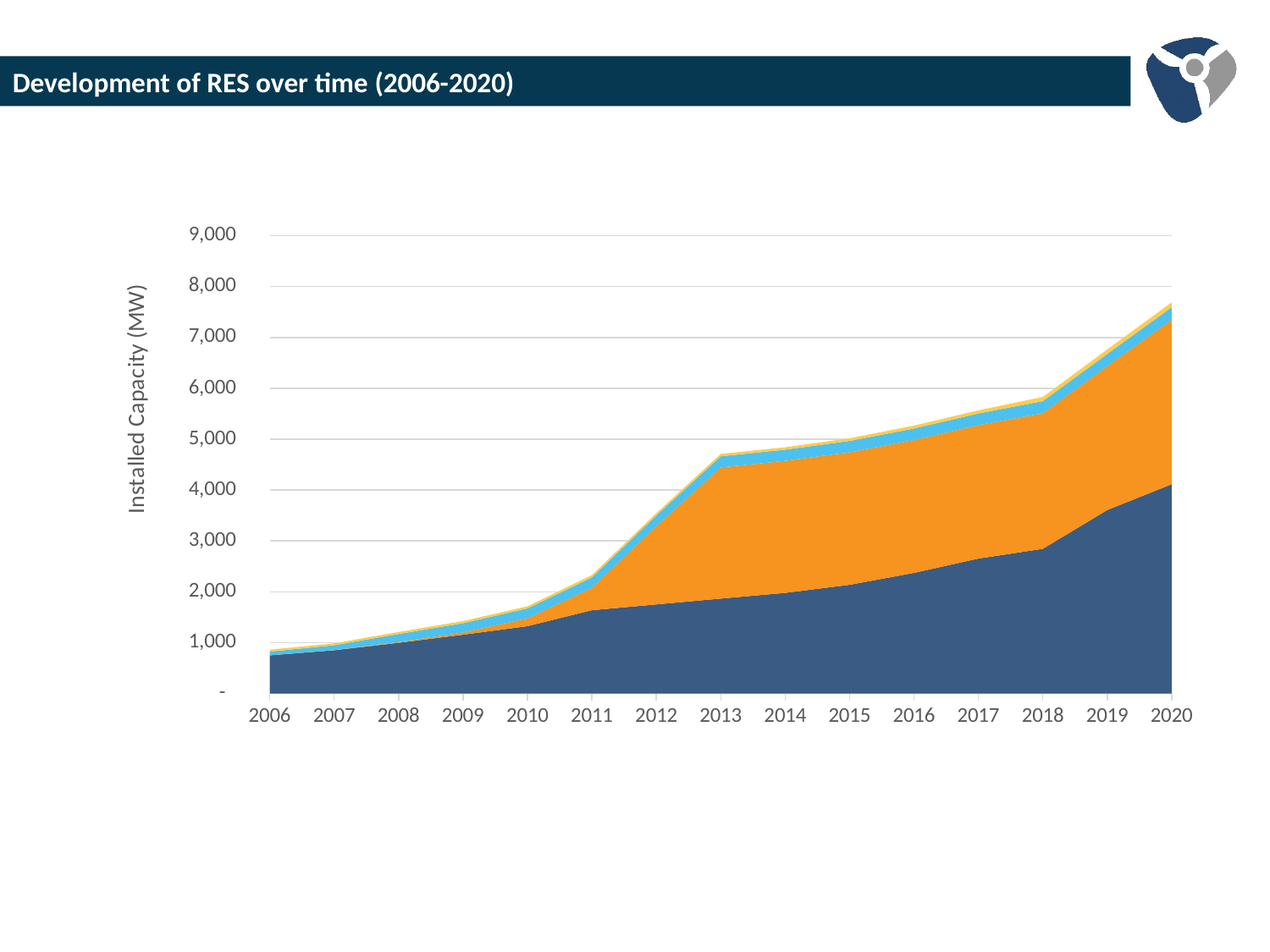
In which year is the total installed capacity highest? 2020 Is the value of the bottom (dark blue) series in 2010 greater or less than 1,000? greater In which year is the total installed capacity lowest? 2006 How many years are shown along the x axis of the chart? 15 Is the total installed capacity in 2013 greater or less than 5,000? less Is the total installed capacity in 2020 greater or less than 7,000? greater What kind of chart is shown on the slide? Stacked area chart What is the title of the slide containing the chart? Development of RES over time (2006-2020) Which year has the larger total installed capacity, 2012 or 2013? 2013 What is the label of the vertical axis of the chart? Installed Capacity (MW) Does the total installed capacity rise or fall from 2006 to 2020? Rise